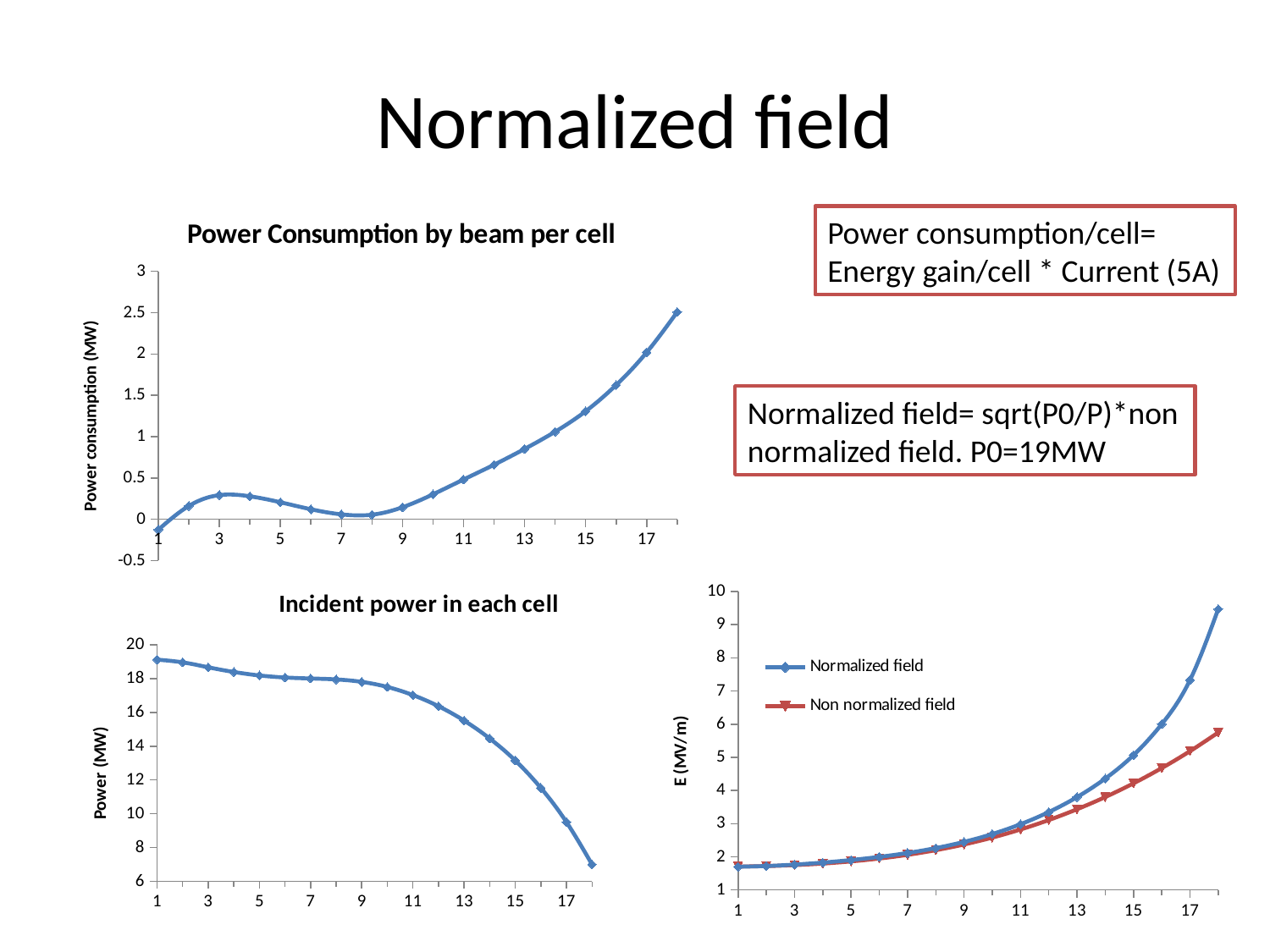
In the "Incident power in each cell" chart, is the value at cell 1 greater or less than 18? greater In the "Power Consumption by beam per cell" chart, which cell has the highest power consumption? 18 In the "Incident power in each cell" chart, is the value at cell 18 greater or less than 8? less What kind of chart is the "Power Consumption by beam per cell" chart? line chart In the "Incident power in each cell" chart, do the values rise or fall as the cell number increases? fall In the bottom-right chart, is the Non normalized field value at cell 18 greater or less than 6? less What is the y-axis label of the bottom-right chart? E (MV/m) How many data points are plotted in the "Power Consumption by beam per cell" chart? 18 How many series does the legend of the bottom-right chart list? 2 In the bottom-right chart, which series has the larger value at cell 18, Normalized field or Non normalized field? Normalized field